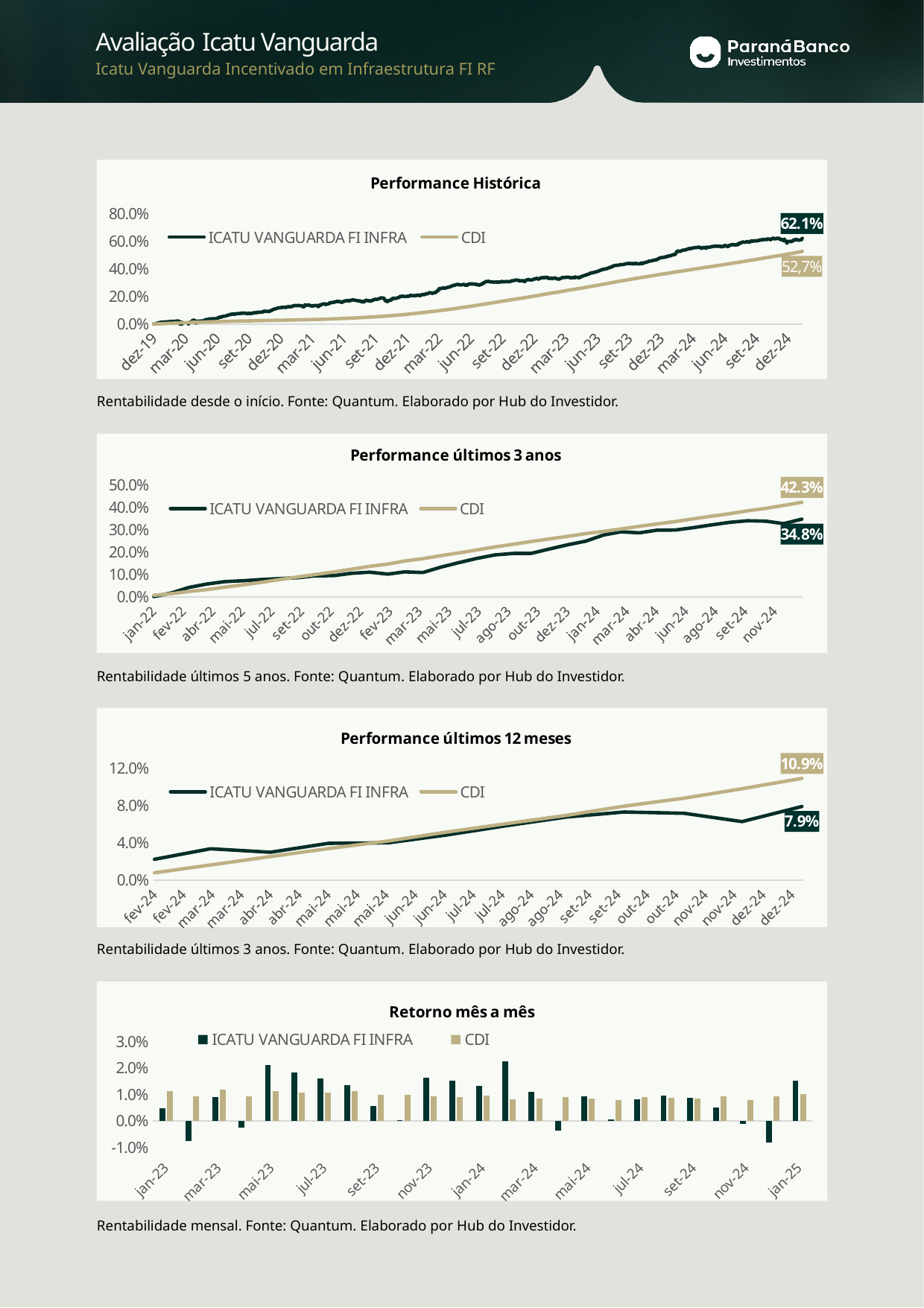
In the 'Performance últimos 12 meses' chart, which series ends higher, ICATU VANGUARDA FI INFRA or CDI? CDI In the 'Performance últimos 3 anos' chart, what is the final value shown for ICATU VANGUARDA FI INFRA? 34.8% In the 'Performance últimos 3 anos' chart, what is the difference between the final CDI value and the final ICATU VANGUARDA FI INFRA value? 7.5% What kind of chart is 'Retorno mês a mês'? Bar chart In the 'Performance últimos 3 anos' chart, what is the final value shown for CDI? 42.3% How many series does the legend of the 'Retorno mês a mês' chart list? 2 In the 'Performance Histórica' chart, what is the final value shown for CDI? 52,7% In the 'Performance últimos 12 meses' chart, what is the final value shown for CDI? 10.9% In the 'Performance Histórica' chart, which series ends higher, ICATU VANGUARDA FI INFRA or CDI? ICATU VANGUARDA FI INFRA In the 'Performance últimos 12 meses' chart, what is the final value shown for ICATU VANGUARDA FI INFRA? 7.9% In the 'Retorno mês a mês' chart, is the value for ICATU VANGUARDA FI INFRA in jan-25 greater or less than 1.0%? greater In the 'Performance Histórica' chart, what is the final value shown for ICATU VANGUARDA FI INFRA? 62.1%